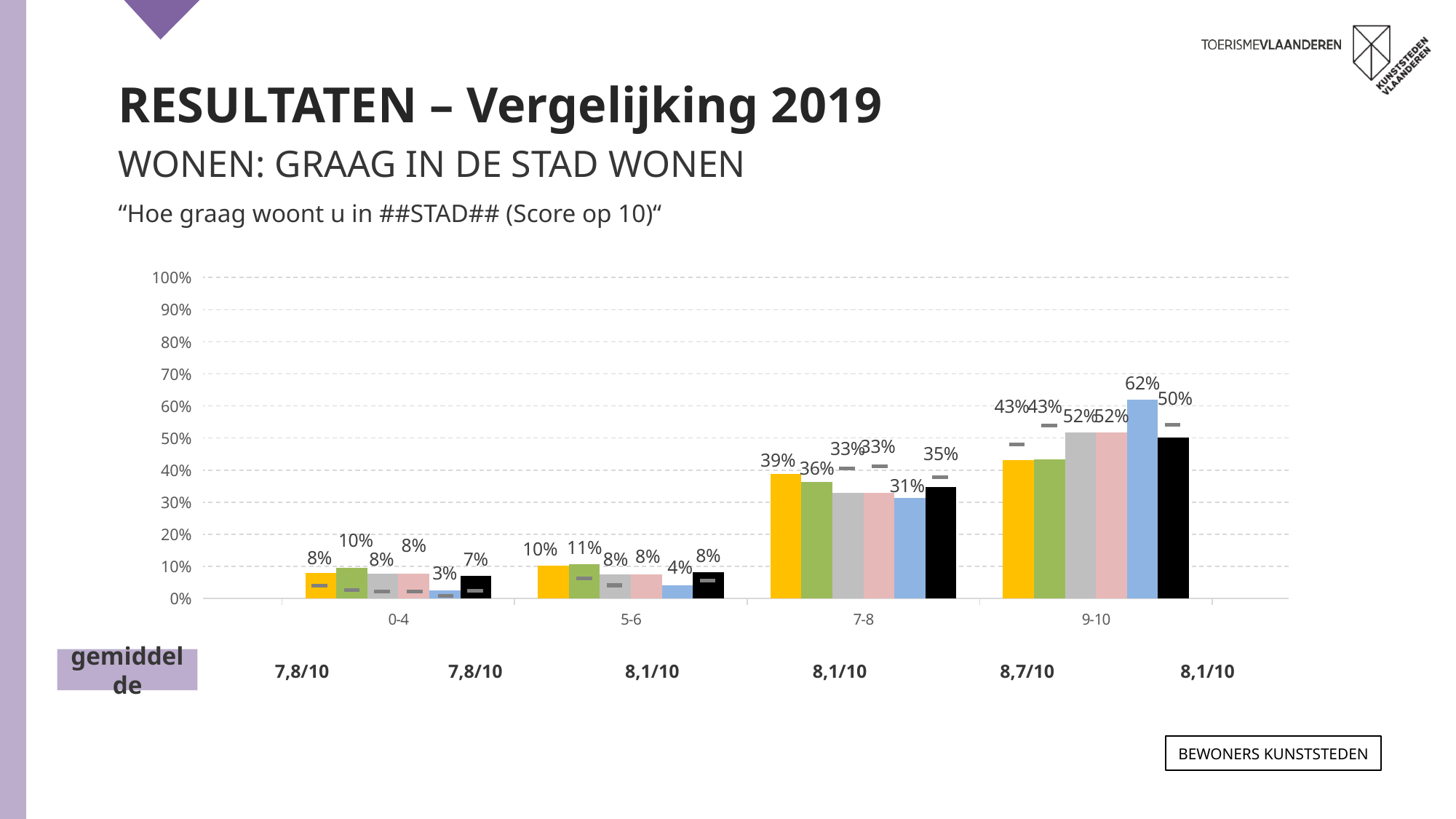
Is the value of the grey bar in the 9-10 category greater or less than 40%? greater Which score category has the highest bar in the chart? 9-10 What is the difference between the blue bar (62%) and the black bar (50%) in the 9-10 category? 12% What kind of chart is shown on the slide? bar chart What is the question quoted above the chart? "Hoe graag woont u in ##STAD## (Score op 10)" What is the value of the black bar in the 9-10 category? 50% In the 7-8 category, which is larger: the yellow bar or the blue bar? the yellow bar What is the value of the blue bar in the 0-4 category? 3% What is the value of the yellow bar in the 7-8 category? 39% How many bars are plotted in each score category of the chart? 6 What is the value of the blue bar in the 9-10 category? 62% How many score categories are shown on the x axis of the chart? 4